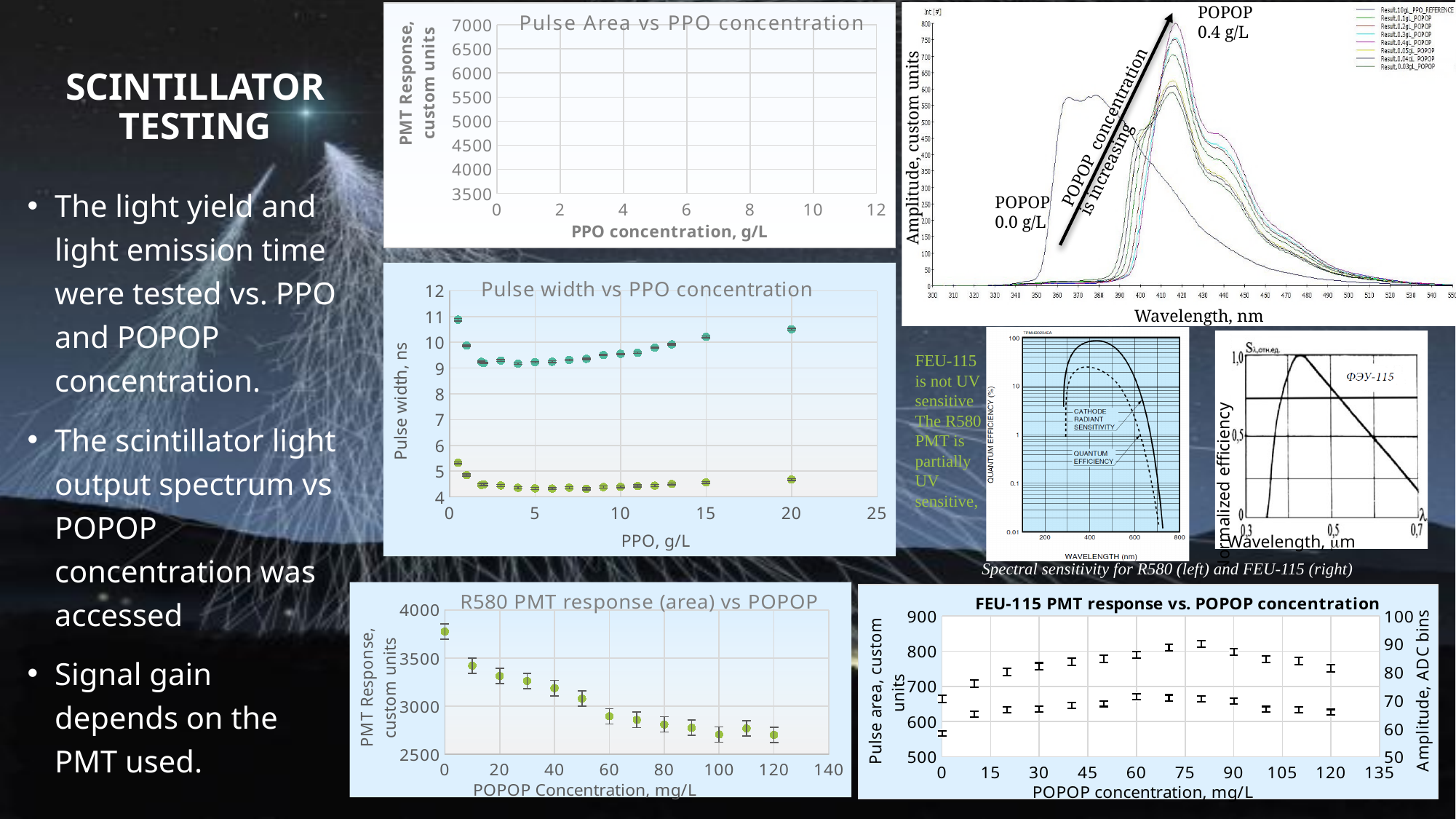
In the 'R580 PMT response (area) vs POPOP' chart, which POPOP concentration has the highest PMT response? 0 mg/L In the 'R580 PMT response (area) vs POPOP' chart, is the value at 120 mg/L greater or less than 3000? less In the spectrum chart at the top right, is the peak of the POPOP 0.0 g/L curve at a wavelength greater or less than 400 nm? less What kind of chart is the 'R580 PMT response (area) vs POPOP' chart? scatter chart What is the x-axis label of the 'R580 PMT response (area) vs POPOP' chart? POPOP Concentration, mg/L In the 'R580 PMT response (area) vs POPOP' chart, which is larger: the value at 0 mg/L or the value at 120 mg/L? 0 mg/L What is the title of the chart at the bottom right of the slide? FEU-115 PMT response vs. POPOP concentration In the 'R580 PMT response (area) vs POPOP' chart, how many data points are plotted? 13 In the 'Pulse width vs PPO concentration' chart, is the lower series value at 20 g/L greater or less than 5 ns? less In the 'R580 PMT response (area) vs POPOP' chart, do the values rise or fall as POPOP concentration increases? fall